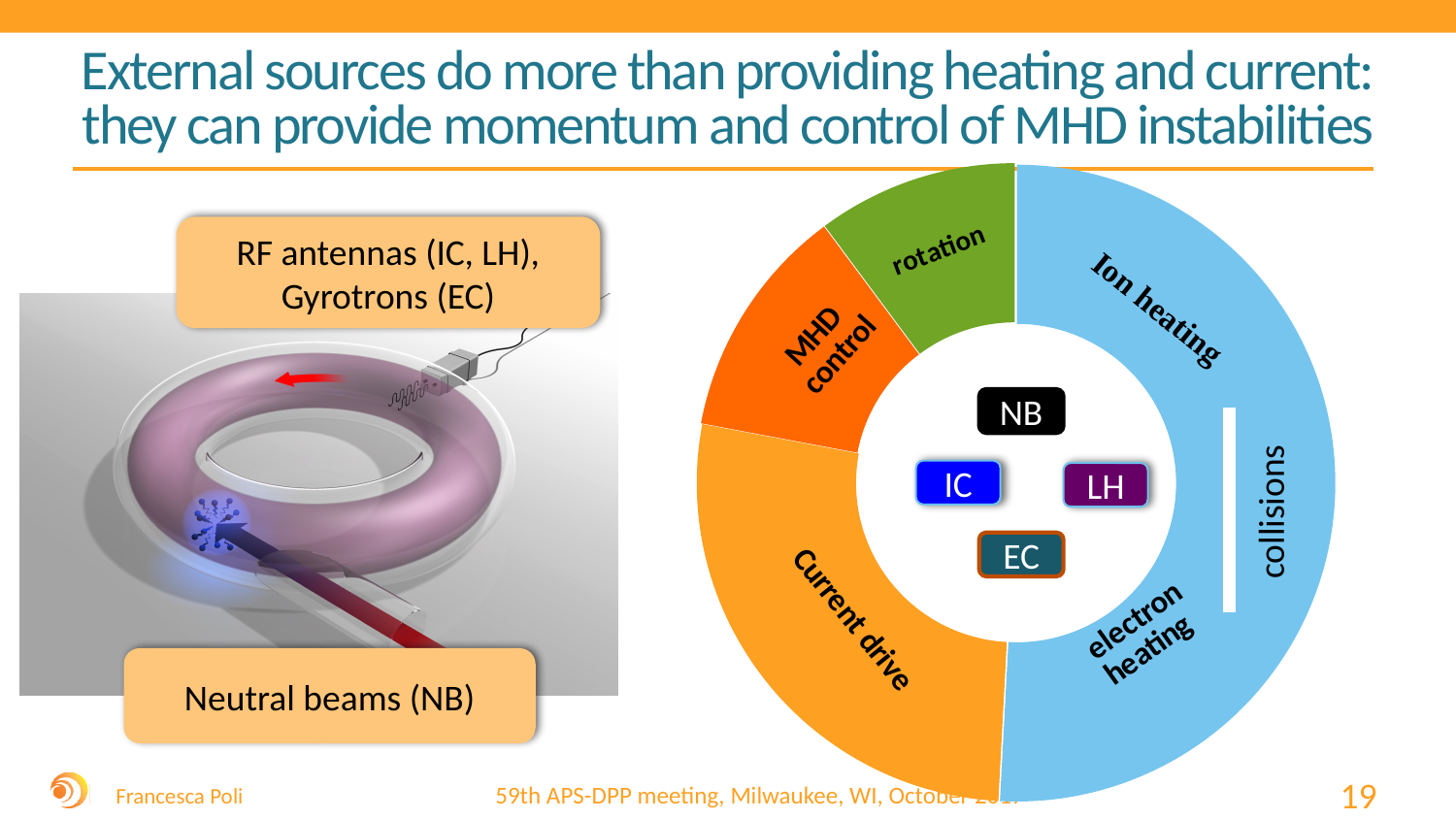
Which two labels appear on the blue segment of the doughnut chart? Ion heating and electron heating Which is larger in the doughnut chart, the blue heating segment or the Current drive segment? The blue heating segment Which segment of the doughnut chart is the largest? The blue segment (Ion heating / electron heating) How many coloured segments does the doughnut chart have? 4 Which four source labels appear in the centre of the doughnut chart? NB, IC, LH, EC Which is larger in the doughnut chart, the Current drive segment or the MHD control segment? Current drive What colour is the Current drive segment of the doughnut chart? Orange What kind of chart is shown on the right side of the slide? Doughnut (ring) chart Which is larger in the doughnut chart, the Current drive segment or the rotation segment? Current drive What colour is the rotation segment of the doughnut chart? Green